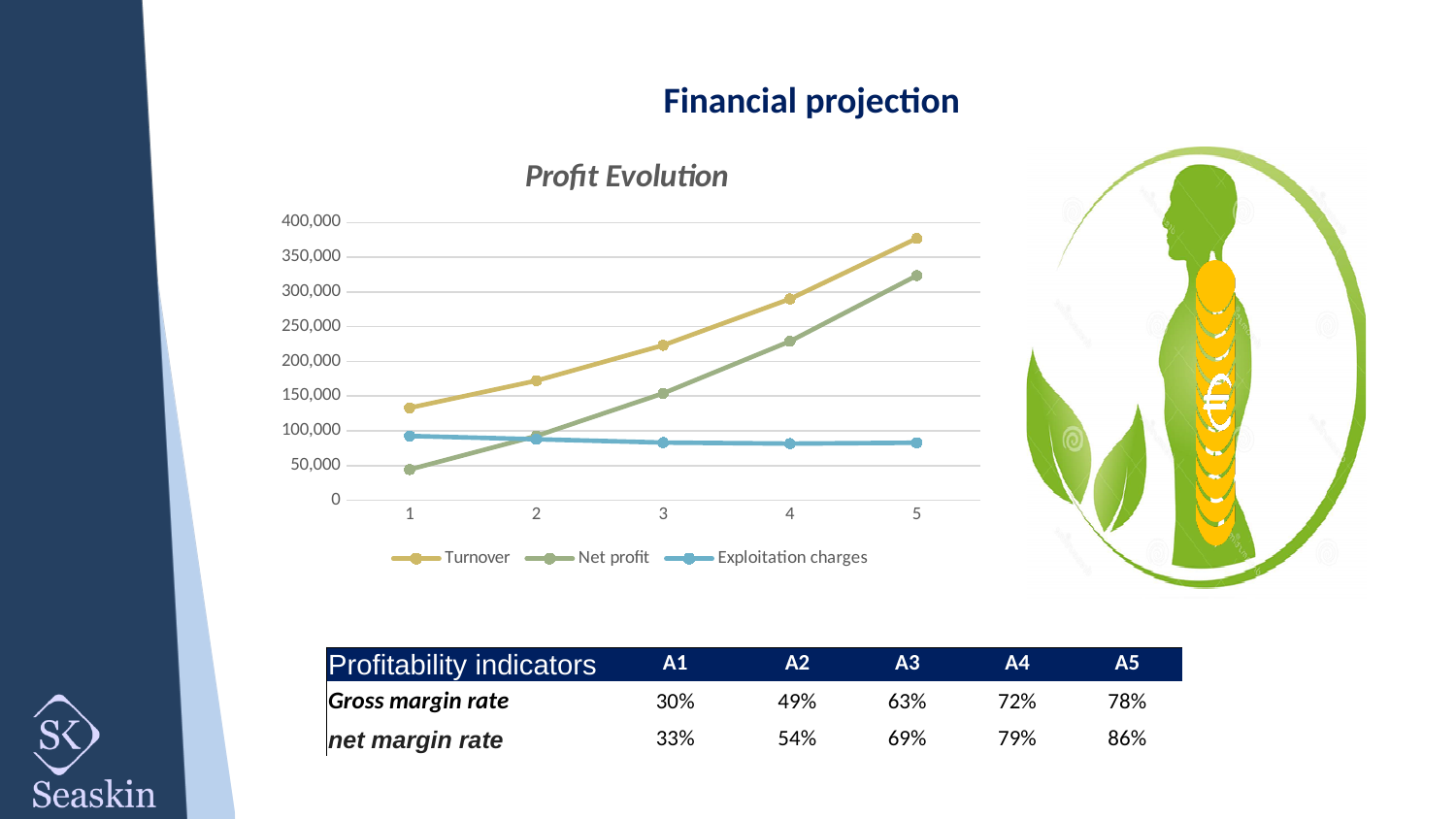
How many points are plotted along the x axis for each series in the Profit Evolution chart? 5 What are the three legend entries of the Profit Evolution chart? Turnover, Net profit, Exploitation charges In the Profit Evolution chart, is the Exploitation charges value at point 3 greater or less than 100,000? less In the Profit Evolution chart, at point 4, which is larger: Turnover or Net profit? Turnover In the Profit Evolution chart, does the Turnover series rise or fall from point 1 to point 5? rise In the Profit Evolution chart, is the Net profit value at point 5 greater or less than 300,000? greater In the Profit Evolution chart, is the Turnover value at point 1 greater or less than 100,000? greater In the Profit Evolution chart, which series has the highest value at point 5? Turnover How many series does the legend of the Profit Evolution chart list? 3 In the Profit Evolution chart, at point 1, which is larger: Net profit or Exploitation charges? Exploitation charges What kind of chart is the Profit Evolution chart? line chart